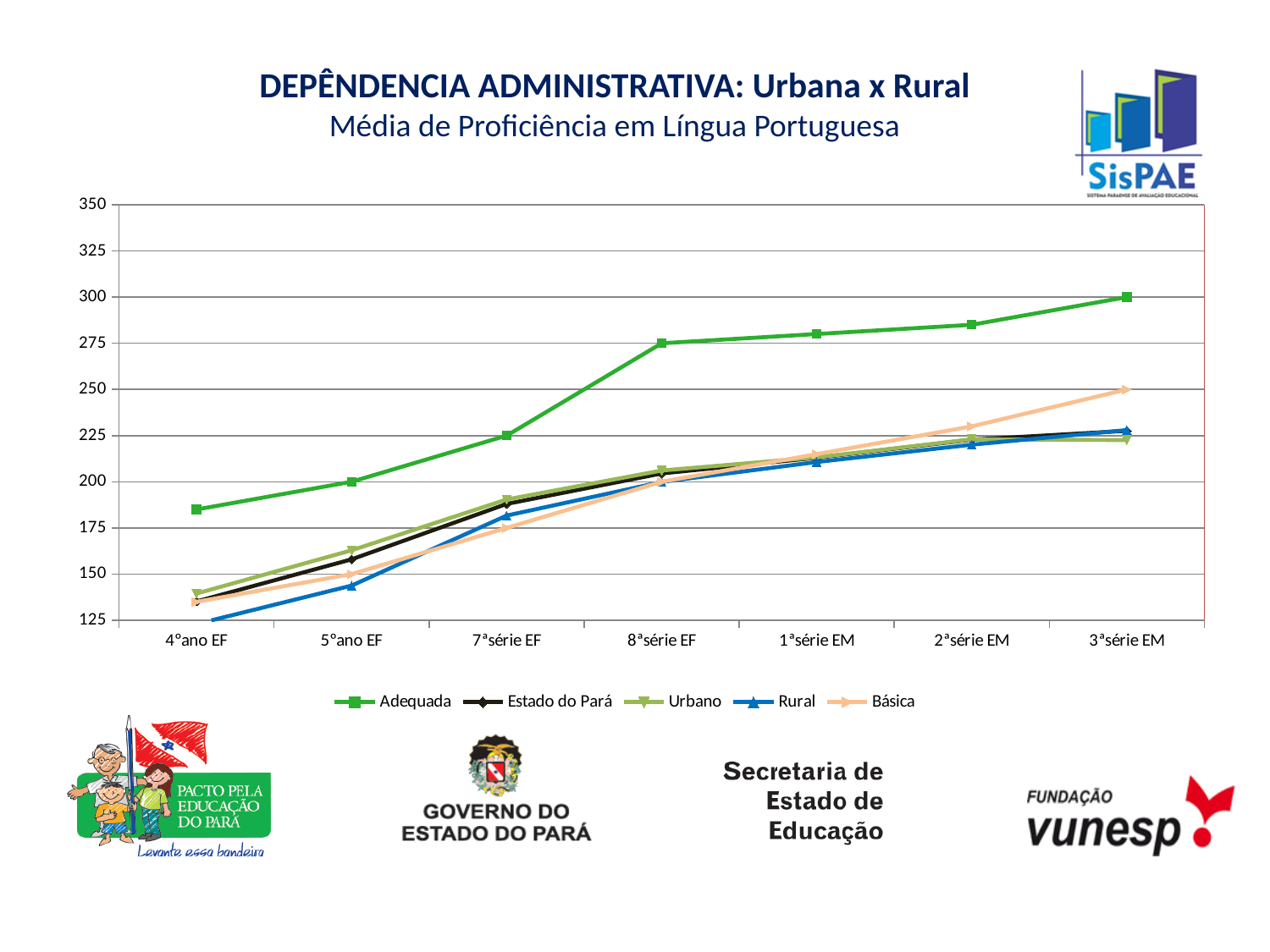
What kind of chart is shown on the slide? Line chart Do the values of the Adequada series rise or fall from 4°ano EF to 3ªsérie EM? rise Which series has the lowest value at 4°ano EF? Rural Which series has the highest values across all categories? Adequada How many series does the legend list? 5 Is the value for the Adequada series at 4°ano EF greater or less than 175? greater How many categories are shown on the x axis? 7 What is the value of the Básica series at 3ªsérie EM? 250 What is the value of the Adequada series at 8ªsérie EF? 275 What is the value of the Adequada series at 3ªsérie EM? 300 Which series is plotted with a green line and square markers? Adequada